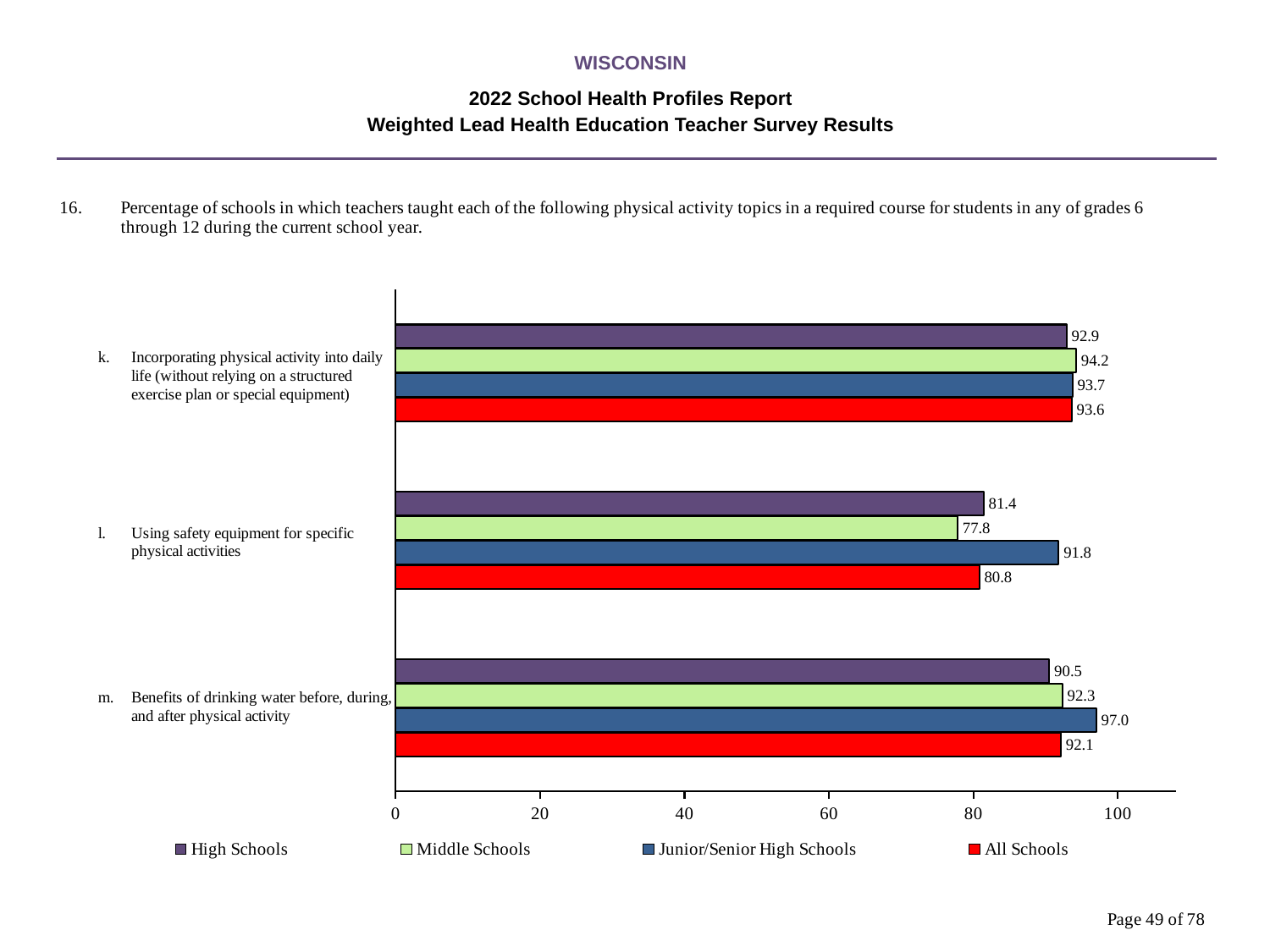
Which school type has the lowest value for topic l, using safety equipment for specific physical activities? Middle Schools Which colour represents All Schools in the legend? Red What is the value for All Schools for topic m, benefits of drinking water before, during, and after physical activity? 92.1 What is the value for High Schools for topic l, using safety equipment for specific physical activities? 81.4 Which is larger for topic k, incorporating physical activity into daily life: the High Schools value or the Middle Schools value? Middle Schools What is the value for Junior/Senior High Schools for topic l, using safety equipment for specific physical activities? 91.8 Which school type has the highest value for topic m, benefits of drinking water before, during, and after physical activity? Junior/Senior High Schools What is the value for Middle Schools for topic k, incorporating physical activity into daily life? 94.2 Is the value for Middle Schools for topic l, using safety equipment for specific physical activities, greater or less than 80? less What kind of chart is shown on the slide? Bar chart How many series does the legend list? 4 What is the difference between the Junior/Senior High Schools and Middle Schools values for topic l, using safety equipment for specific physical activities? 14.0